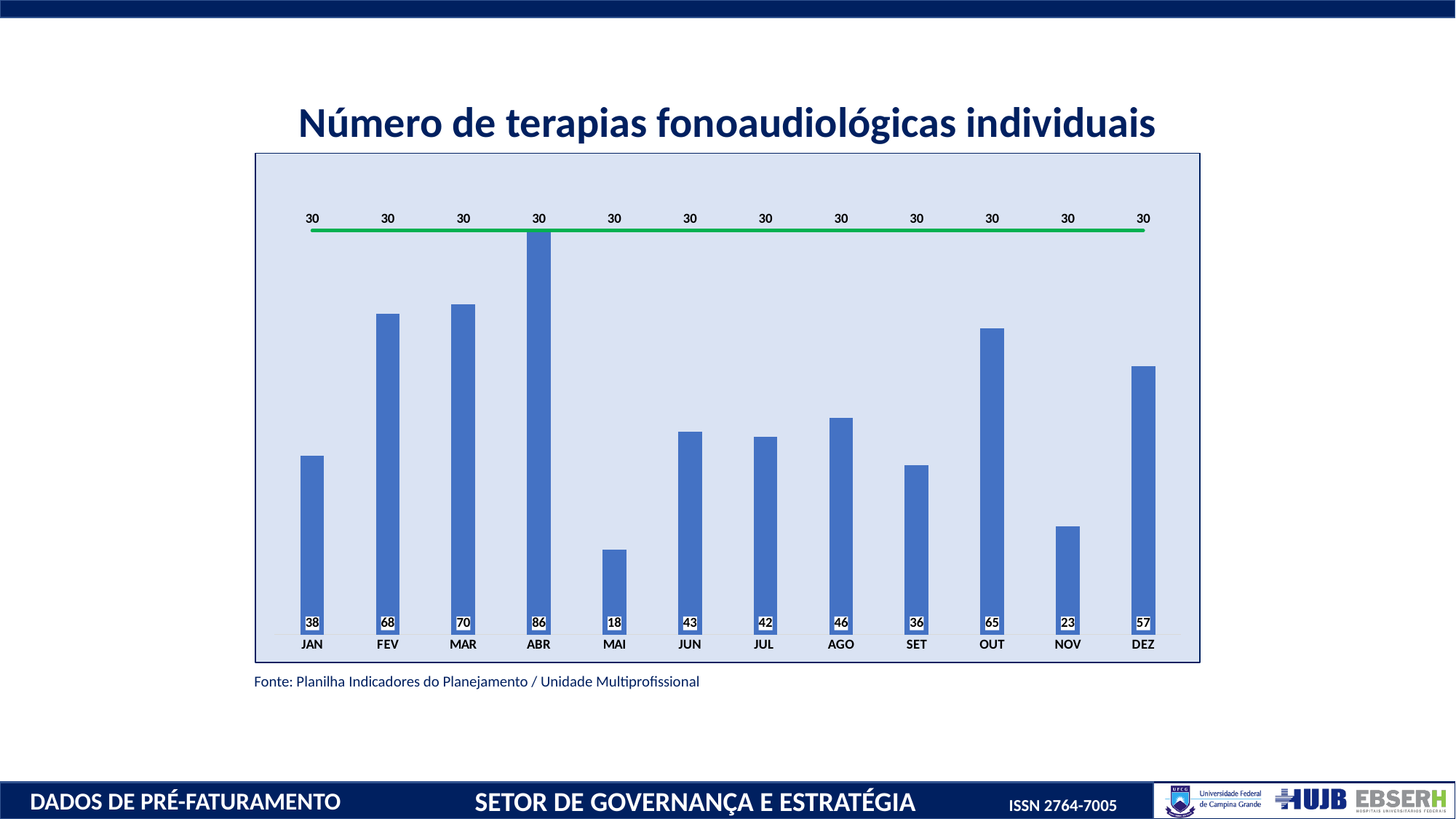
What kind of chart is this? Combination bar and line chart What is the difference between the values for FEV and JAN? 30 What is the value for MAI? 18 Which month has the lowest number of individual speech therapies? MAI What is the value for ABR? 86 What is the difference between the values for ABR and MAI? 68 Which is larger, the value for JUN or the value for SET? JUN Which is larger, the value for DEZ or the value for NOV? DEZ How many months are shown on the x axis? 12 What value does the green line show for every month? 30 What is the value for OUT? 65 Which month has the highest number of individual speech therapies? ABR